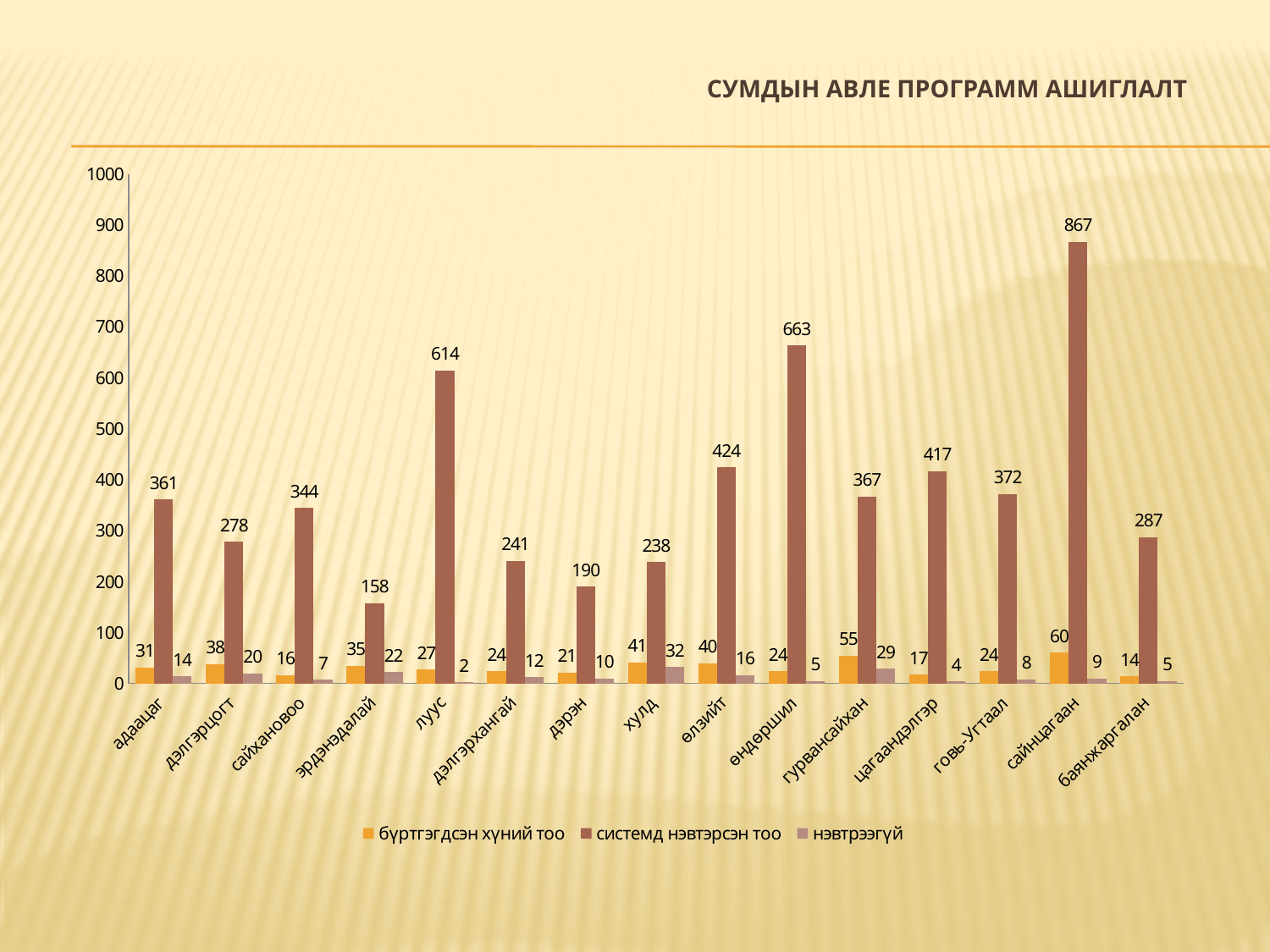
What kind of chart is shown on the slide? bar chart Which category has the lowest value for системд нэвтэрсэн тоо? эрдэнэдалай What is the difference between the системд нэвтэрсэн тоо values for сайнцагаан and өндөршил? 204 How many categories are shown on the x axis? 15 How many series does the legend list? 3 Is the системд нэвтэрсэн тоо value for өндөршил greater or less than 600? greater What is the value of системд нэвтэрсэн тоо for сайнцагаан? 867 Which category has the lowest value for нэвтрээгүй? луус What is the value of нэвтрээгүй for хулд? 32 What is the value of бүртгэгдсэн хүний тоо for гурвансайхан? 55 Which is larger, the системд нэвтэрсэн тоо value for луус or for өлзийт? луус Which category has the highest value for системд нэвтэрсэн тоо? сайнцагаан